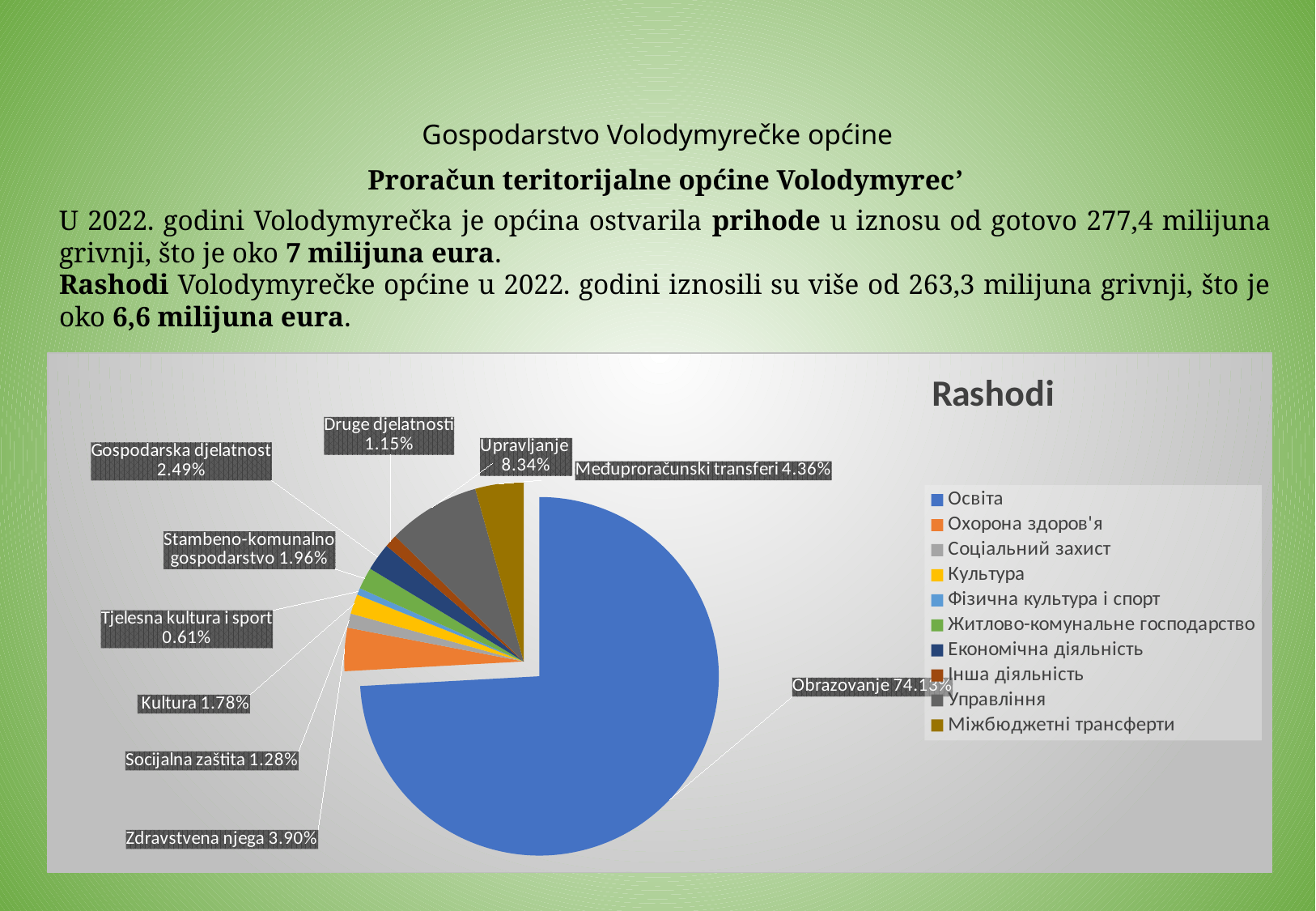
Which is larger, Gospodarska djelatnost or Kultura? Gospodarska djelatnost Which category has the largest slice of the pie? Obrazovanje What is the title of the pie chart? Rashodi What share of the pie does Obrazovanje have? 74.13% What kind of chart is shown on the slide? pie chart What is the value shown for Međuproračunski transferi? 4.36% What is the value shown for Zdravstvena njega? 3.90% How many entries does the legend list? 10 Which category has the smallest slice of the pie? Tjelesna kultura i sport What is the difference between the values for Upravljanje and Međuproračunski transferi? 3.98% What is the value shown for Upravljanje? 8.34% What is the value shown for Tjelesna kultura i sport? 0.61%